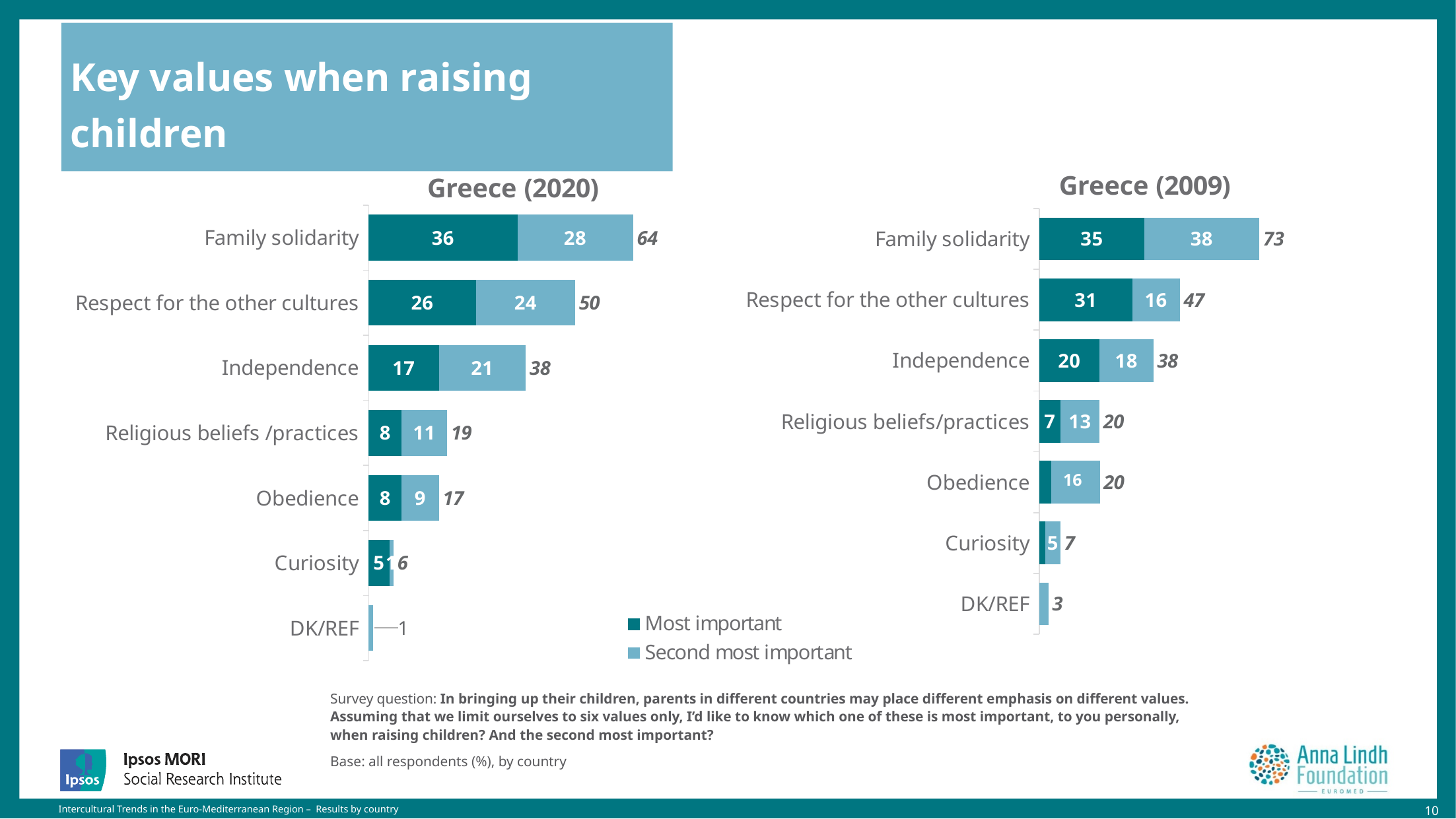
In the Greece (2020) chart, what is the 'Second most important' value for Independence? 21 In the Greece (2020) chart, what is the 'Most important' value for Family solidarity? 36 In the Greece (2009) chart, what is the 'Second most important' value for Family solidarity? 38 In the Greece (2009) chart, what is the total for Independence? 38 How many series does the legend list? 2 In the Greece (2020) chart, which category has the highest total? Family solidarity How many categories are shown in the Greece (2020) chart? 7 What kind of chart is the Greece (2009) chart? Stacked bar chart In the Greece (2009) chart, which is larger: the 'Most important' value for Respect for the other cultures or for Independence? Respect for the other cultures In the Greece (2009) chart, which category has the lowest total? DK/REF In the Greece (2020) chart, what is the difference between the 'Most important' values for Family solidarity and Respect for the other cultures? 10 In the Greece (2020) chart, what is the total for Respect for the other cultures? 50